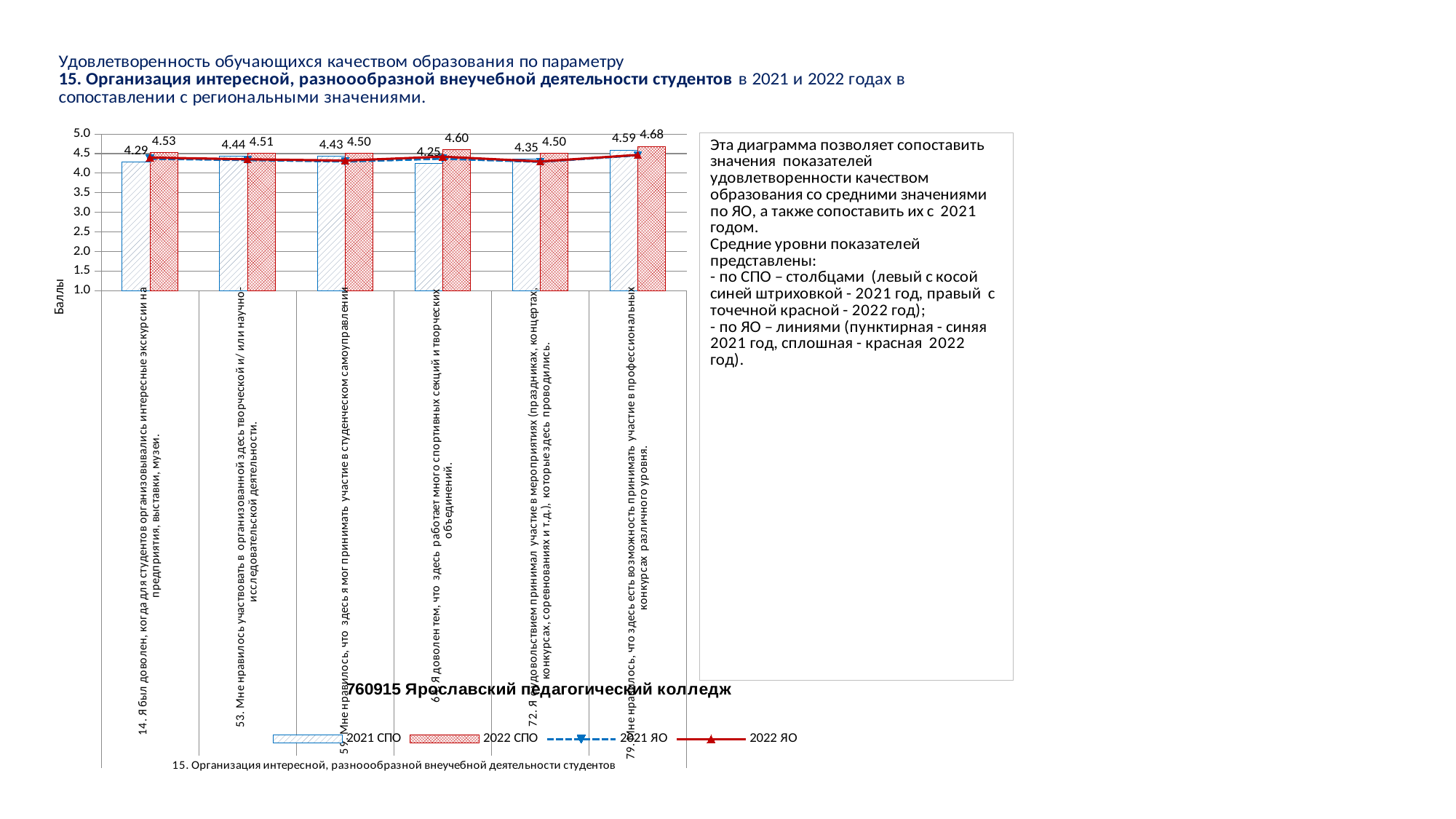
What is the 2021 СПО value for category 72 (participation in events such as holidays, concerts, competitions)? 4.35 What is the 2022 СПО value for category 14 (excursions to enterprises, exhibitions, museums)? 4.53 How many series does the chart legend list? 4 What is the label of the vertical axis of the chart? Баллы What is the 2021 СПО value for category 79 (participation in professional competitions of various levels)? 4.59 How many categories are shown on the x axis of the chart? 6 Which category has the highest 2022 СПО value? 79. Мне нравилось, что здесь есть возможность принимать участие в профессиональных конкурсах различного уровня. What kind of chart is used to show the СПО values? bar chart Is the 2021 СПО value for category 14 greater or less than 4.5? less Which is larger for category 53 (creative and/or research activity): the 2021 СПО value or the 2022 СПО value? 2022 СПО What is the difference between the 2022 СПО and 2021 СПО values for the category about sports sections and creative associations? 0.35 Which category has the lowest 2021 СПО value? Я доволен тем, что здесь работает много спортивных секций и творческих объединений.